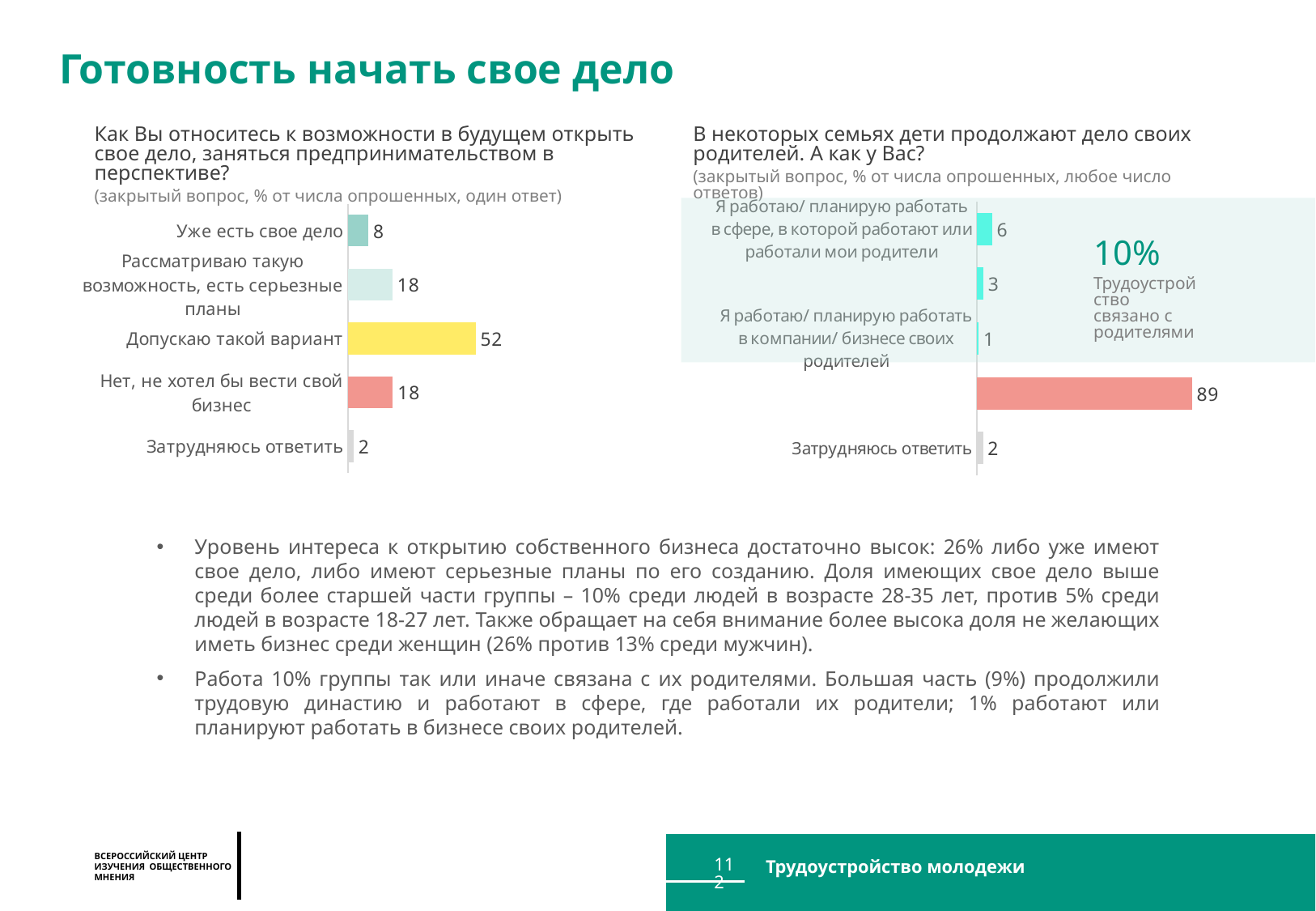
In the left chart (Как Вы относитесь к возможности в будущем открыть свое дело), which category has the highest value? Допускаю такой вариант In the left chart (Как Вы относитесь к возможности в будущем открыть свое дело), what is the value for 'Допускаю такой вариант'? 52 In the left chart (Как Вы относитесь к возможности в будущем открыть свое дело), which is larger: 'Уже есть свое дело' or 'Рассматриваю такую возможность, есть серьезные планы'? Рассматриваю такую возможность, есть серьезные планы In the left chart (Как Вы относитесь к возможности в будущем открыть свое дело), how many categories are shown? 5 In the right chart (В некоторых семьях дети продолжают дело своих родителей), what is the value for 'Затрудняюсь ответить'? 2 In the left chart (Как Вы относитесь к возможности в будущем открыть свое дело), what is the difference between 'Допускаю такой вариант' and 'Нет, не хотел бы вести свой бизнес'? 34 What type of chart is the left chart (Как Вы относитесь к возможности в будущем открыть свое дело)? Bar chart In the right chart (В некоторых семьях дети продолжают дело своих родителей), what is the value for 'Я работаю/ планирую работать в компании/ бизнесе своих родителей'? 1 In the left chart (Как Вы относитесь к возможности в будущем открыть свое дело), which category has the lowest value? Затрудняюсь ответить In the right chart (В некоторых семьях дети продолжают дело своих родителей), what is the value of the largest bar? 89 In the right chart (В некоторых семьях дети продолжают дело своих родителей), what is the value for 'Я работаю/ планирую работать в сфере, в которой работают или работали мои родители'? 6 In the left chart (Как Вы относитесь к возможности в будущем открыть свое дело), what is the value for 'Уже есть свое дело'? 8